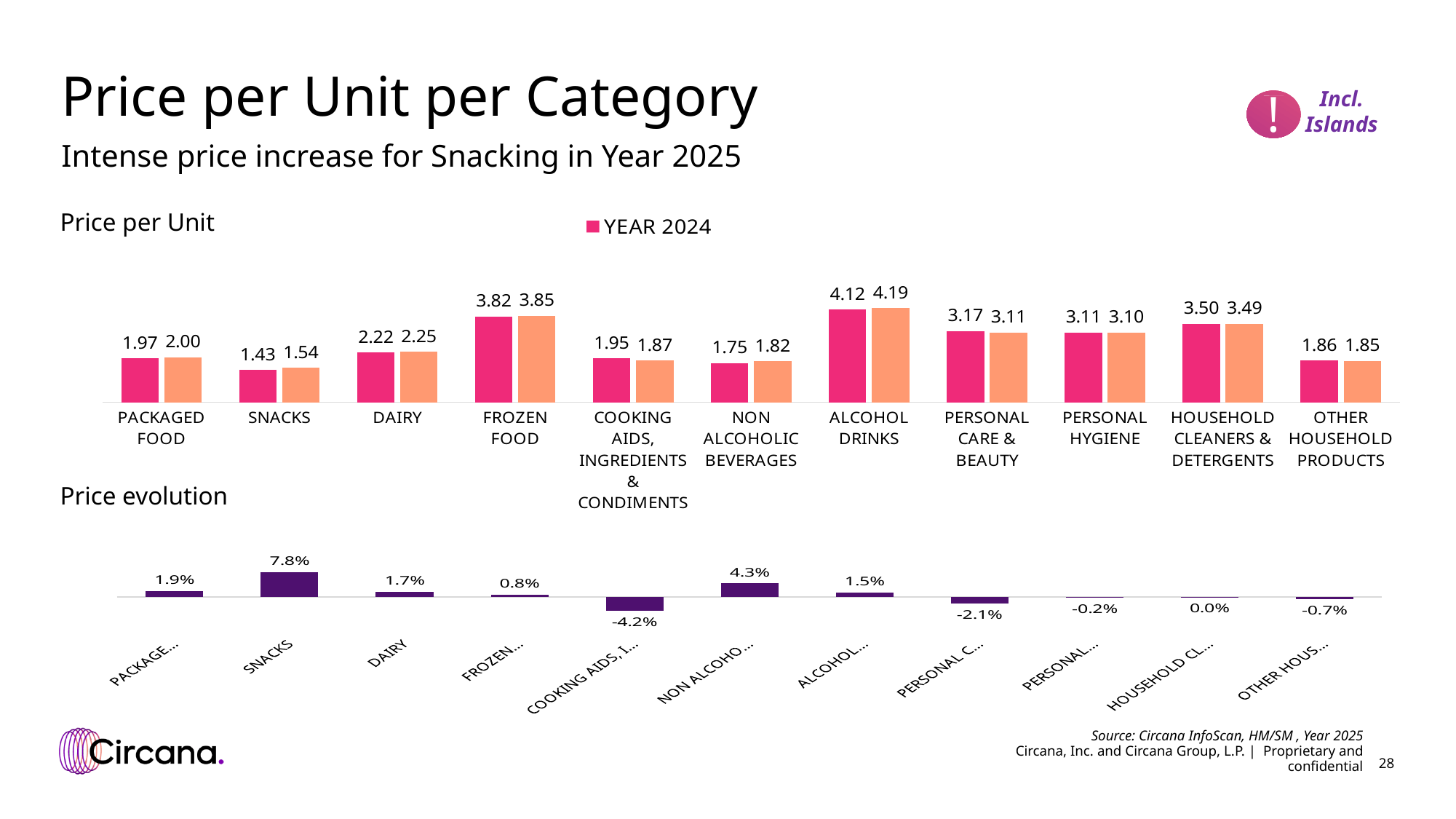
In the Price per Unit chart, what is the difference between the two values shown for ALCOHOL DRINKS (4.19 and 4.12)? 0.07 In the Price per Unit chart, which category has the highest YEAR 2024 value? ALCOHOL DRINKS What kind of chart is the Price evolution chart? Bar chart In the Price evolution chart, what is the value for SNACKS? 7.8% In the Price per Unit chart, what is the YEAR 2024 value for ALCOHOL DRINKS? 4.12 In the Price per Unit chart, what is the YEAR 2024 value for SNACKS? 1.43 In the Price evolution chart, what is the difference between the SNACKS value (7.8%) and the DAIRY value (1.7%)? 6.1 percentage points In the Price per Unit chart, which has the larger YEAR 2024 value: PERSONAL CARE & BEAUTY or HOUSEHOLD CLEANERS & DETERGENTS? HOUSEHOLD CLEANERS & DETERGENTS What is the only entry shown in the legend of the Price per Unit chart? YEAR 2024 In the Price per Unit chart, which category has the lowest YEAR 2024 value? SNACKS How many categories are shown in the Price per Unit chart? 11 In the Price evolution chart, which category has the lowest value? COOKING AIDS